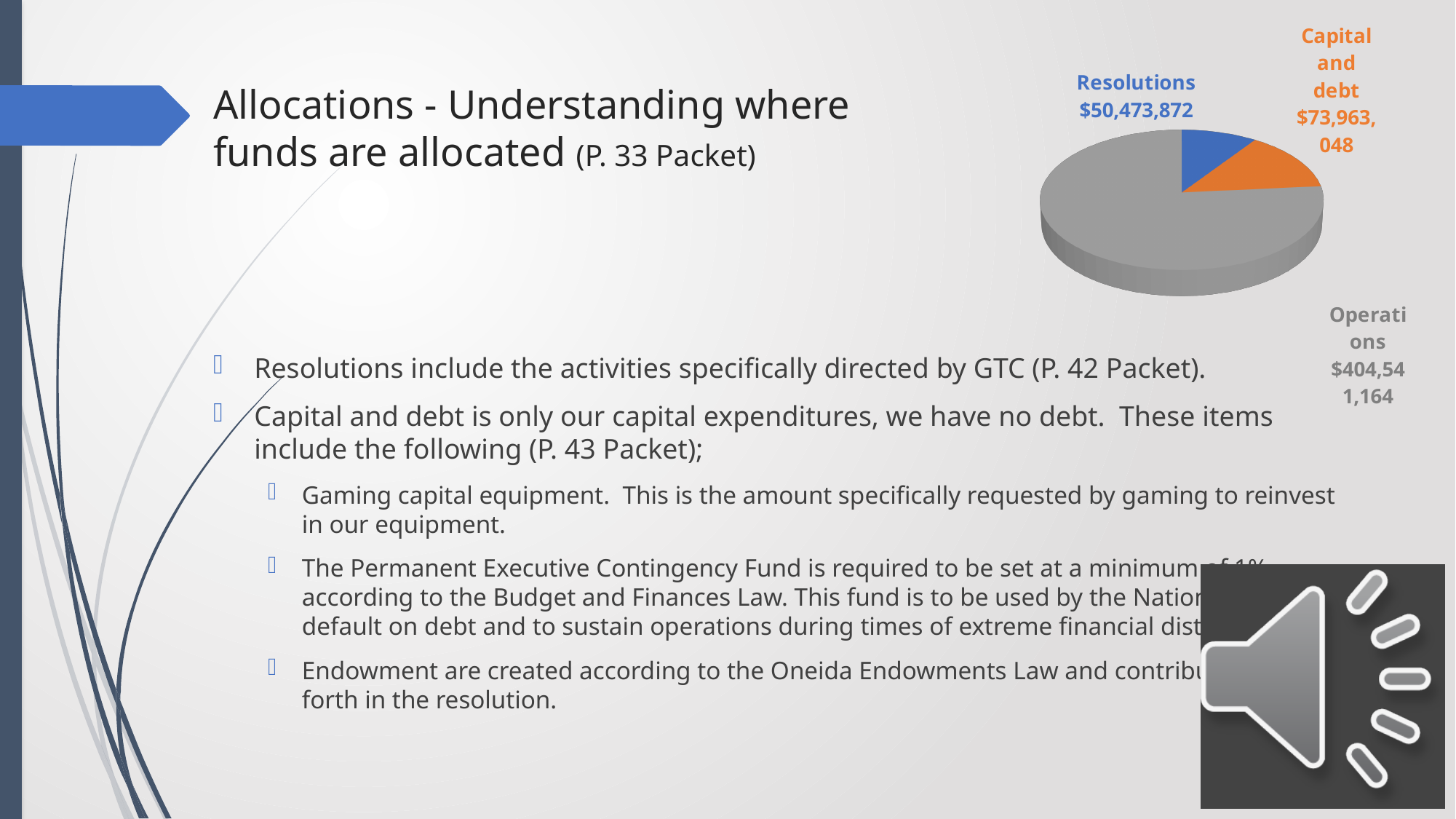
What colour is the Capital and debt slice in the pie chart? Orange Which category has the largest slice in the pie chart? Operations What is the difference between Capital and debt and Resolutions? $23,489,176 How many slices does the pie chart have? 3 What is the value for Capital and debt in the pie chart? $73,963,048 What kind of chart is shown on the slide? Pie chart What is the value for Operations in the pie chart? $404,541,164 Which category has the smallest slice in the pie chart? Resolutions What is the value for Resolutions in the pie chart? $50,473,872 Which is larger, Capital and debt or Resolutions? Capital and debt What is the difference between Operations and Capital and debt? $330,578,116 What is the total of all three slices in the pie chart? $528,978,084